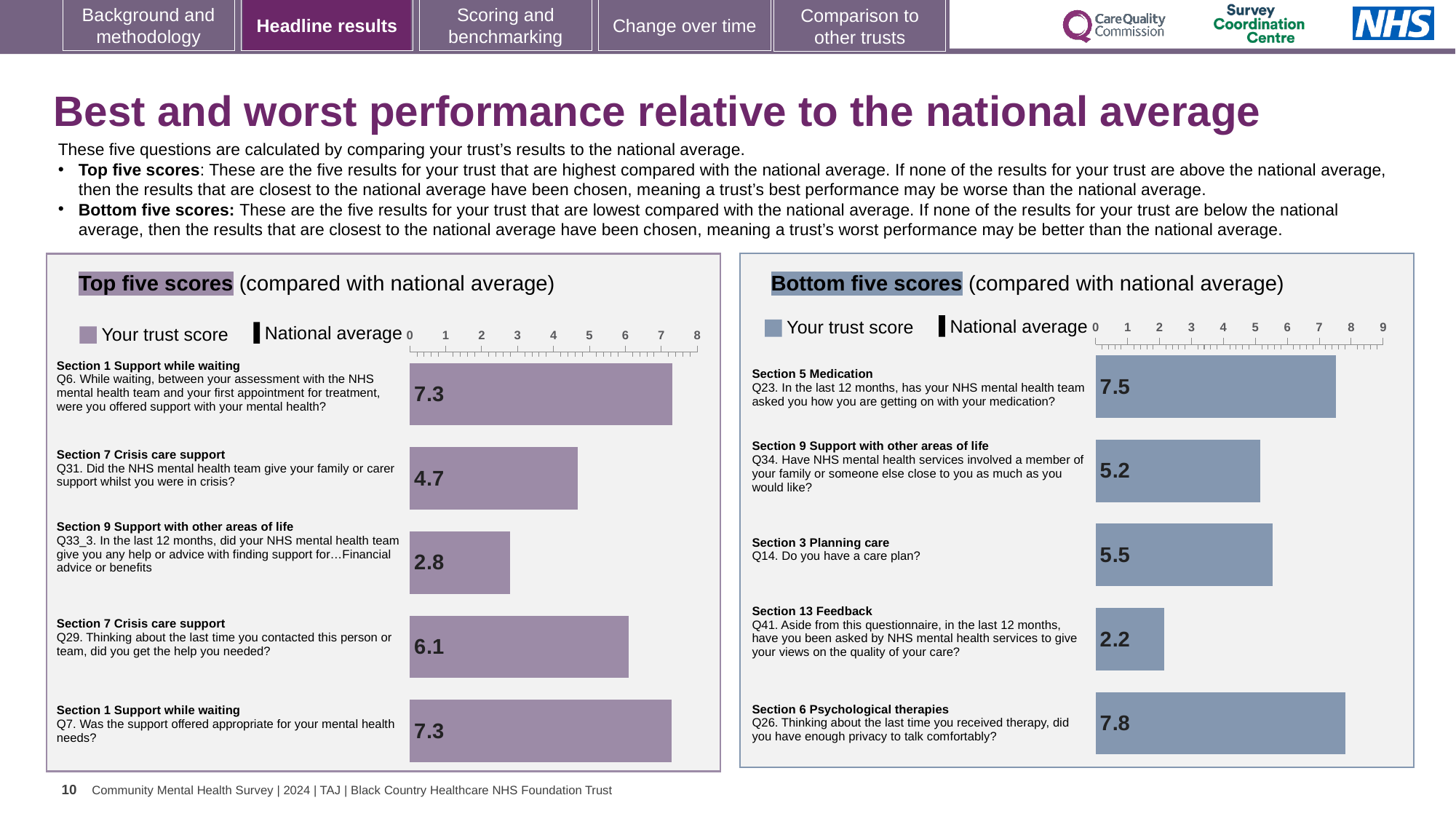
In the 'Bottom five scores' chart, which question has the lowest trust score? Q41 (Section 13 Feedback) In the 'Bottom five scores' chart, what is the difference between the trust scores for Q26 and Q41? 5.6 In the 'Bottom five scores' chart, which question has the highest trust score? Q26 (Section 6 Psychological therapies) In the 'Bottom five scores' chart, what is the trust score for Q41 (asked to give your views on the quality of your care)? 2.2 In the 'Top five scores' chart, what is the trust score for Q6 (support while waiting, offered support with your mental health)? 7.3 In the 'Bottom five scores' chart, which has the larger trust score: Q23 or Q34? Q23 In the 'Bottom five scores' chart, what is the trust score for Q14 (Do you have a care plan?)? 5.5 In the 'Top five scores' chart, what is the difference between the trust scores for Q6 and Q31? 2.6 In the 'Top five scores' chart, which question has the lowest trust score? Q33_3 (Section 9 Support with other areas of life) How many questions are plotted in the 'Top five scores' chart? 5 What type of chart is the 'Bottom five scores' chart? Bar chart In the 'Top five scores' chart, what is the trust score for Q31 (family or carer support whilst in crisis)? 4.7